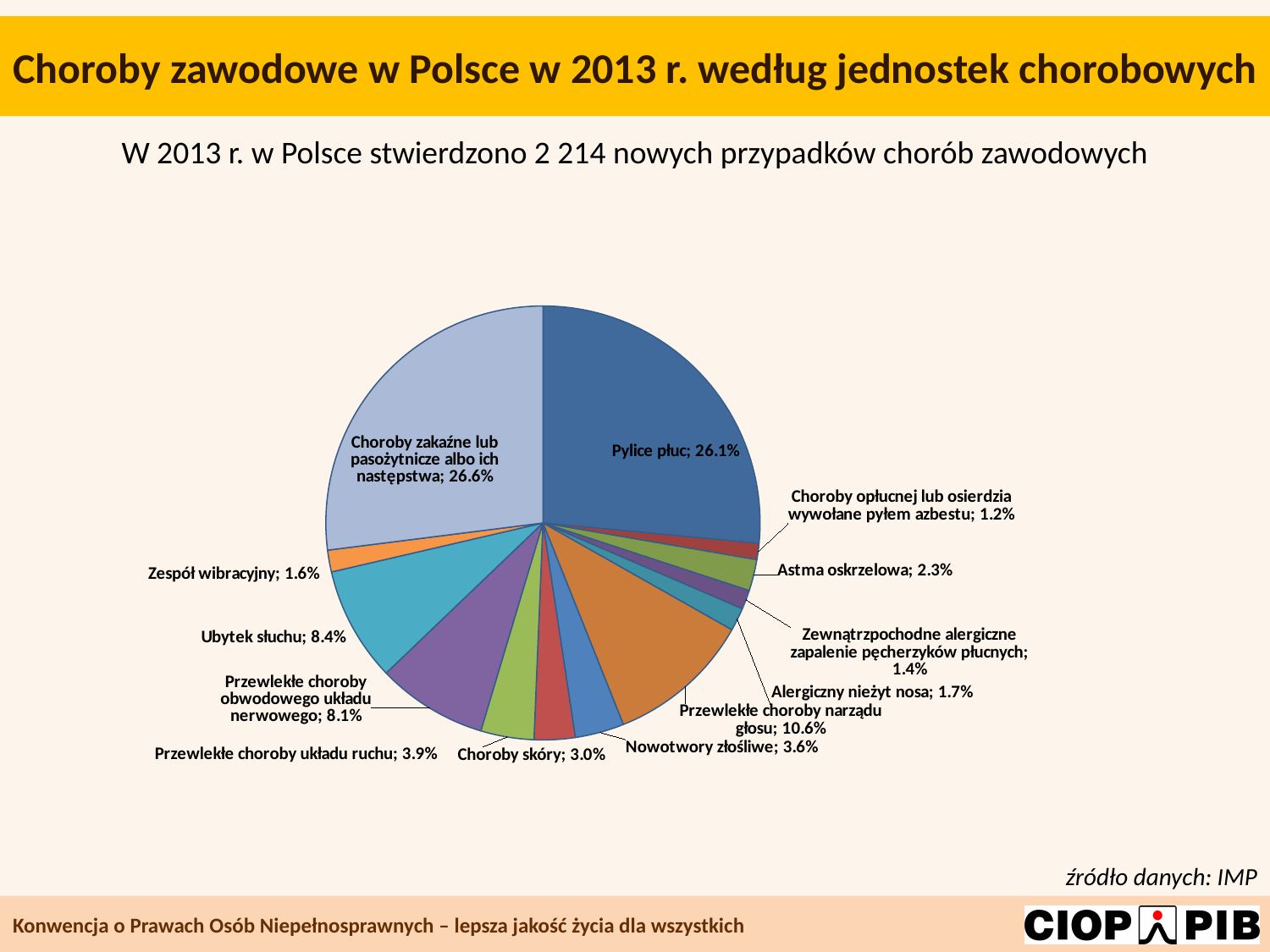
What is the difference in percentage points between "Choroby zakaźne lub pasożytnicze albo ich następstwa" and "Pylice płuc"? 0.5 Which is larger: "Nowotwory złośliwe" or "Choroby skóry"? Nowotwory złośliwe What is the title of the slide containing the chart? Choroby zawodowe w Polsce w 2013 r. według jednostek chorobowych Which category has the largest slice of the pie? Choroby zakaźne lub pasożytnicze albo ich następstwa Which is larger: "Ubytek słuchu" or "Przewlekłe choroby obwodowego układu nerwowego"? Ubytek słuchu How many categories (slices) does the pie chart have? 13 What is the value shown for "Ubytek słuchu"? 8.4% Which category has the smallest slice of the pie? Choroby opłucnej lub osierdzia wywołane pyłem azbestu What kind of chart is shown on the slide? pie chart What share of the pie does "Pylice płuc" represent? 26.1% What is the value shown for "Zespół wibracyjny"? 1.6% What is the value shown for "Przewlekłe choroby narządu głosu"? 10.6%